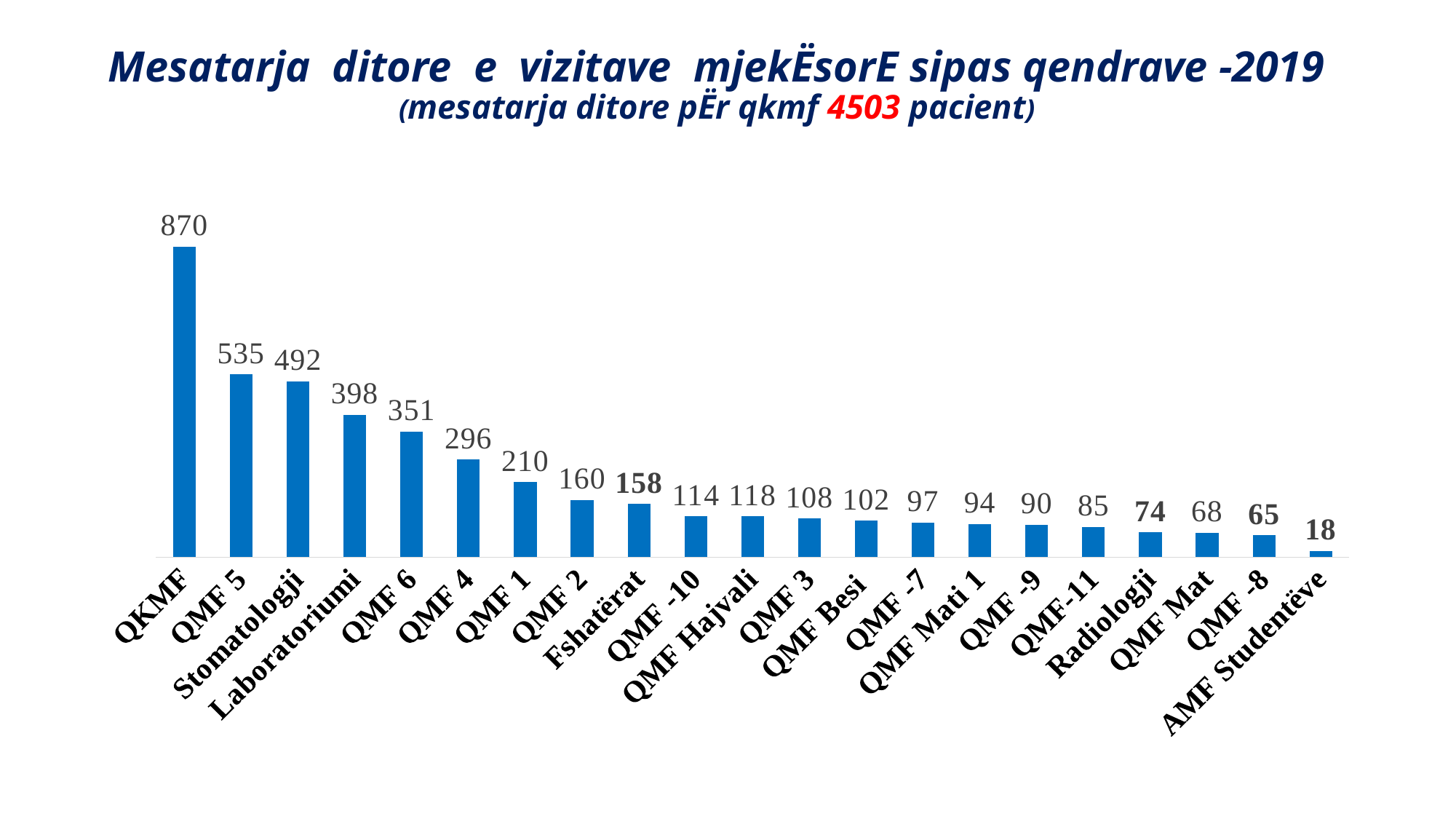
Which is larger, the value for Laboratoriumi or the value for QMF 4? Laboratoriumi What kind of chart is shown on the slide? Bar chart What is the value for QKMF? 870 What is the value for QMF Hajvali? 118 What is the value for Stomatologji? 492 What daily average for qkmf is stated in the chart subtitle? 4503 Which category has the highest value? QKMF What is the value for Radiologji? 74 What is the difference between the values for QMF 1 and QMF -8? 145 Which category has the lowest value? AMF Studentëve What is the difference between the values for QMF 5 and QMF 6? 184 How many categories are shown in the chart? 21